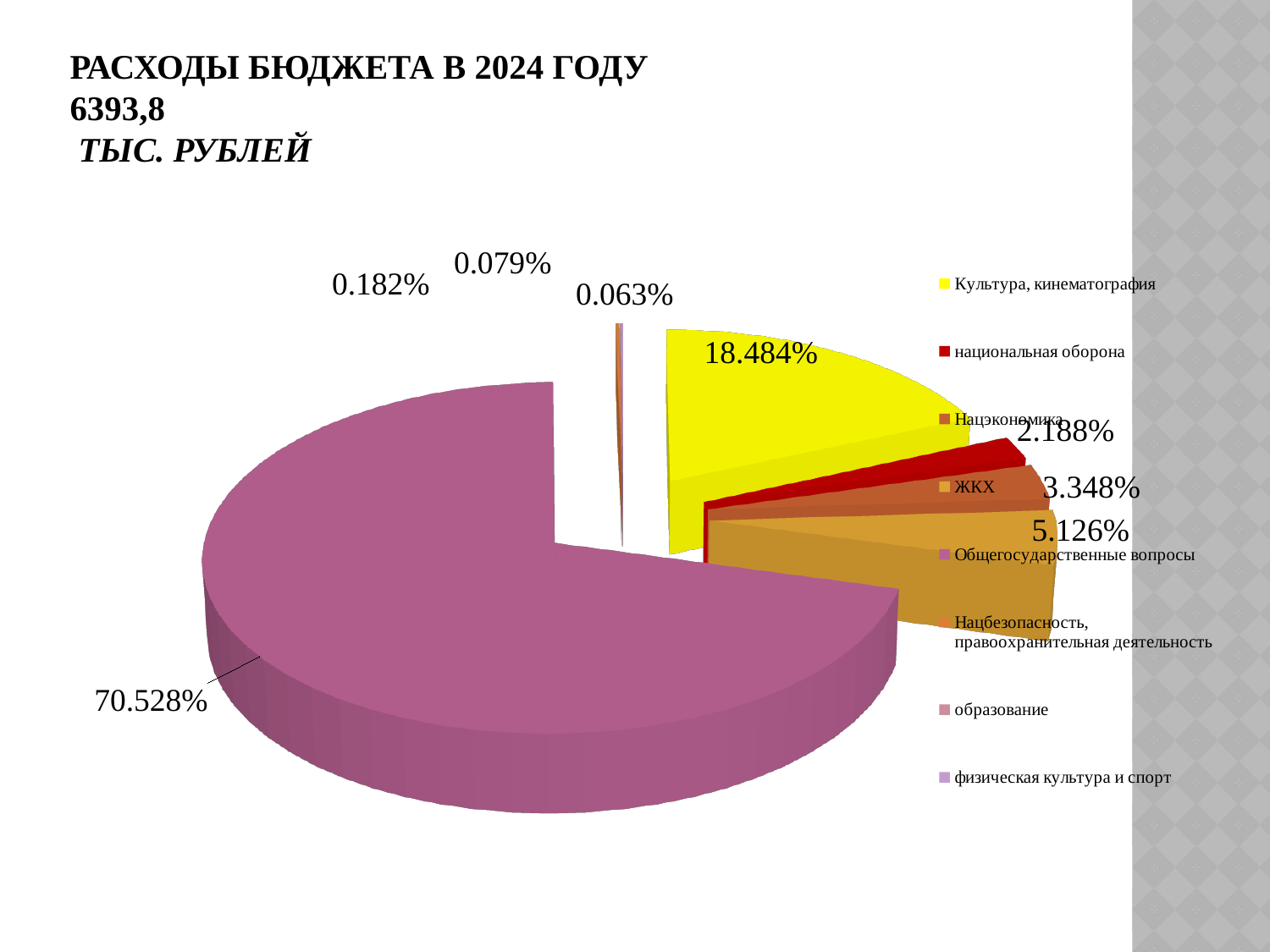
Which category has the largest slice of the pie? Общегосударственные вопросы What is the title of the slide above the chart? РАСХОДЫ БЮДЖЕТА В 2024 ГОДУ What share of the pie does ЖКХ have? 5.126% How many categories does the legend list? 8 What is the difference between the shares of Общегосударственные вопросы and Культура, кинематография? 52.044% What share of the pie does Нацэкономика have? 3.348% What share of the pie does национальная оборона have? 2.188% What kind of chart is shown on the slide? pie chart What share of the pie does Культура, кинематография have? 18.484% What is the smallest percentage labelled on the pie chart? 0.063% Which has the larger share, ЖКХ or Нацэкономика? ЖКХ What share of the pie does Общегосударственные вопросы have? 70.528%